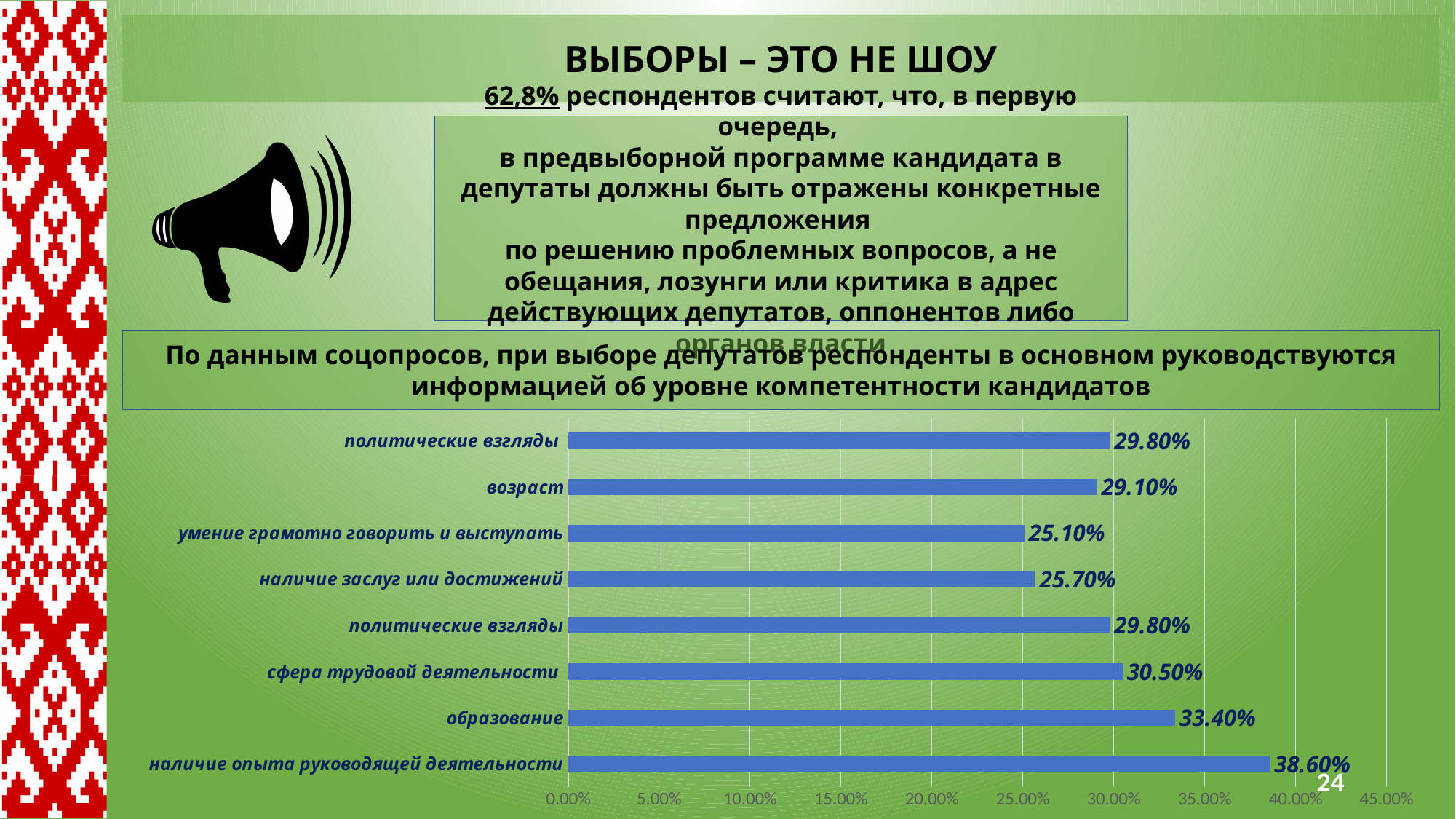
What is the value for 'сфера трудовой деятельности'? 30.50% How many bars does the chart show? 8 What kind of chart is shown on the slide? bar chart Which category has the highest value? наличие опыта руководящей деятельности What is the value for 'умение грамотно говорить и выступать'? 25.10% Which category has the lowest value? умение грамотно говорить и выступать What is the value for 'образование'? 33.40% What is the difference between the values for 'наличие опыта руководящей деятельности' and 'образование'? 5.20% What is the value for 'возраст'? 29.10% Which is larger, the value for 'наличие заслуг или достижений' or the value for 'умение грамотно говорить и выступать'? наличие заслуг или достижений Is the value for 'сфера трудовой деятельности' greater or less than 30.00%? greater What is the value for 'наличие опыта руководящей деятельности'? 38.60%